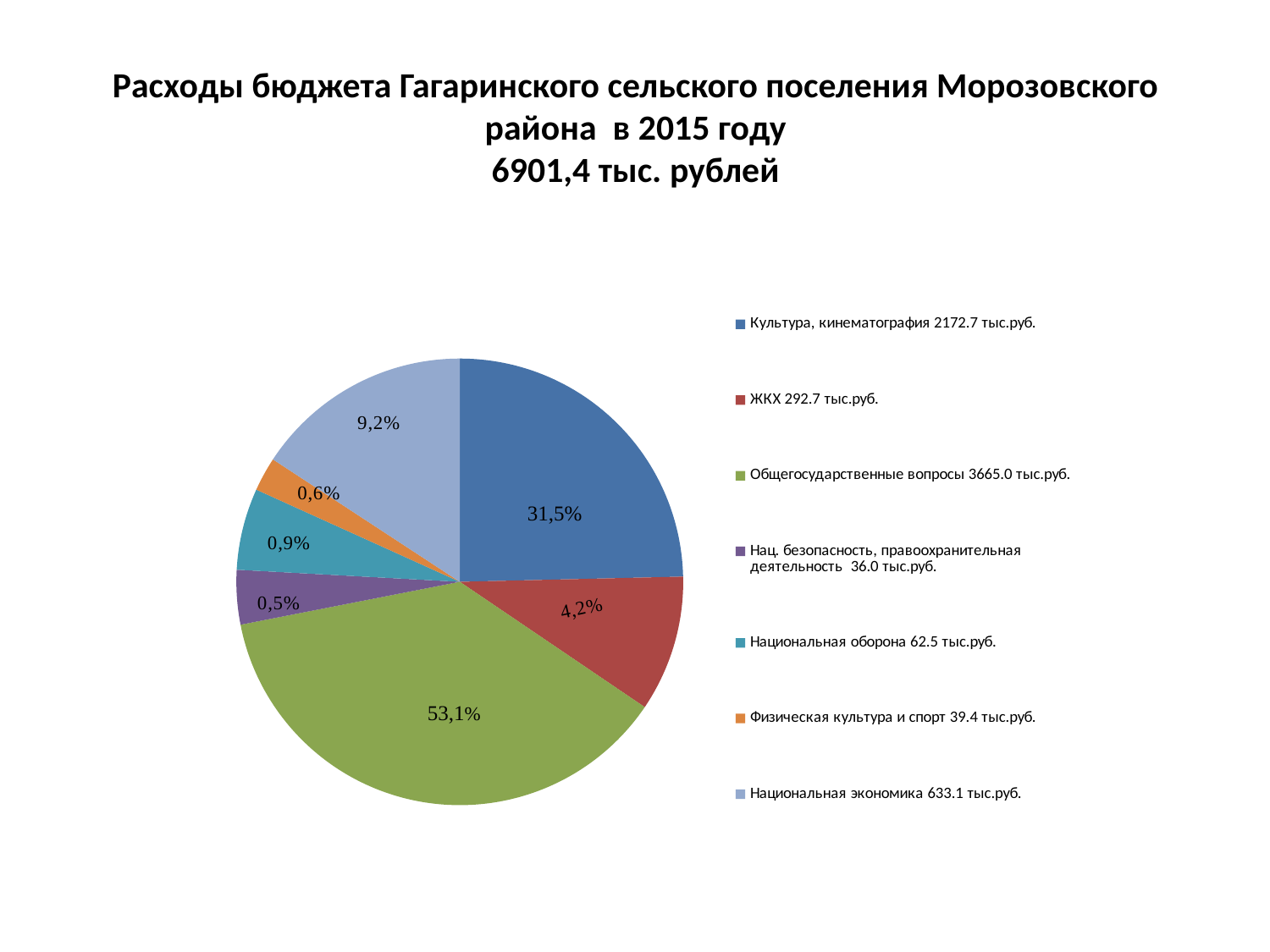
What share of the pie does Культура, кинематография take? 31,5% According to the legend, how many тыс.руб. were spent on Национальная оборона? 62.5 тыс.руб. Which slice is larger: Национальная оборона or Физическая культура и спорт? Национальная оборона What share of the pie does ЖКХ take? 4,2% What total amount of expenditure is stated in the slide title? 6901,4 тыс. рублей What is the difference in percentage points between the Общегосударственные вопросы slice and the Культура, кинематография slice? 21,6 Which category has the largest slice of the pie? Общегосударственные вопросы What share of the pie does Общегосударственные вопросы take? 53,1% What kind of chart is shown on the slide? pie chart How many slices does the pie chart have? 7